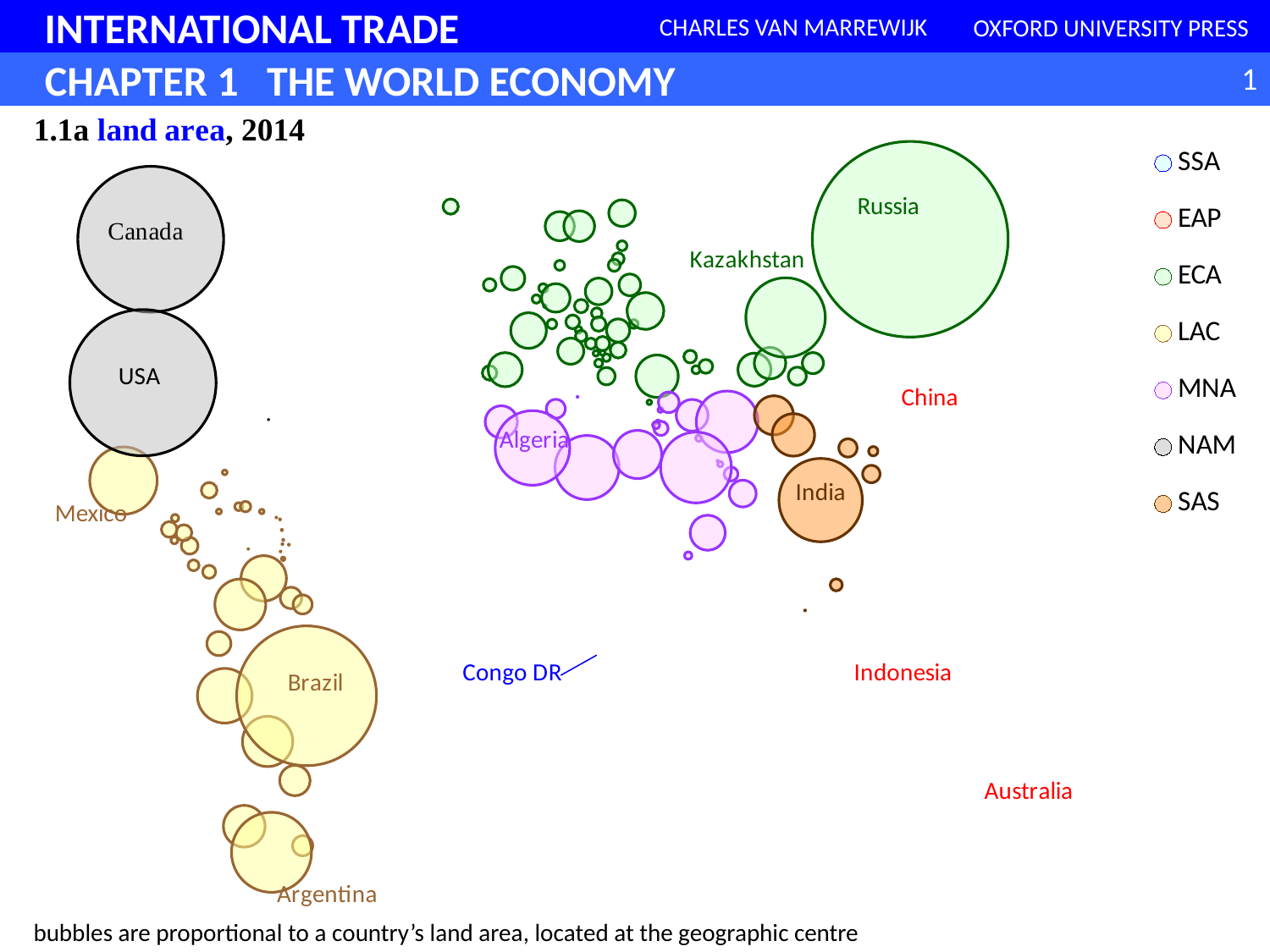
Which country has the largest bubble on the chart? Russia Which bubble is larger, Canada or Mexico? Canada Which bubble is larger, Russia or Kazakhstan? Russia Which bubble is larger, Russia or Canada? Russia According to the legend colours, which region does Algeria belong to? MNA What is the title of the chart? 1.1a land area, 2014 According to the legend colours, which region does India belong to? SAS Which legend entry is shown with a green bubble? ECA According to the legend colours, which region does Brazil belong to? LAC How many regions does the legend list? 7 What kind of chart is shown on the slide? bubble chart